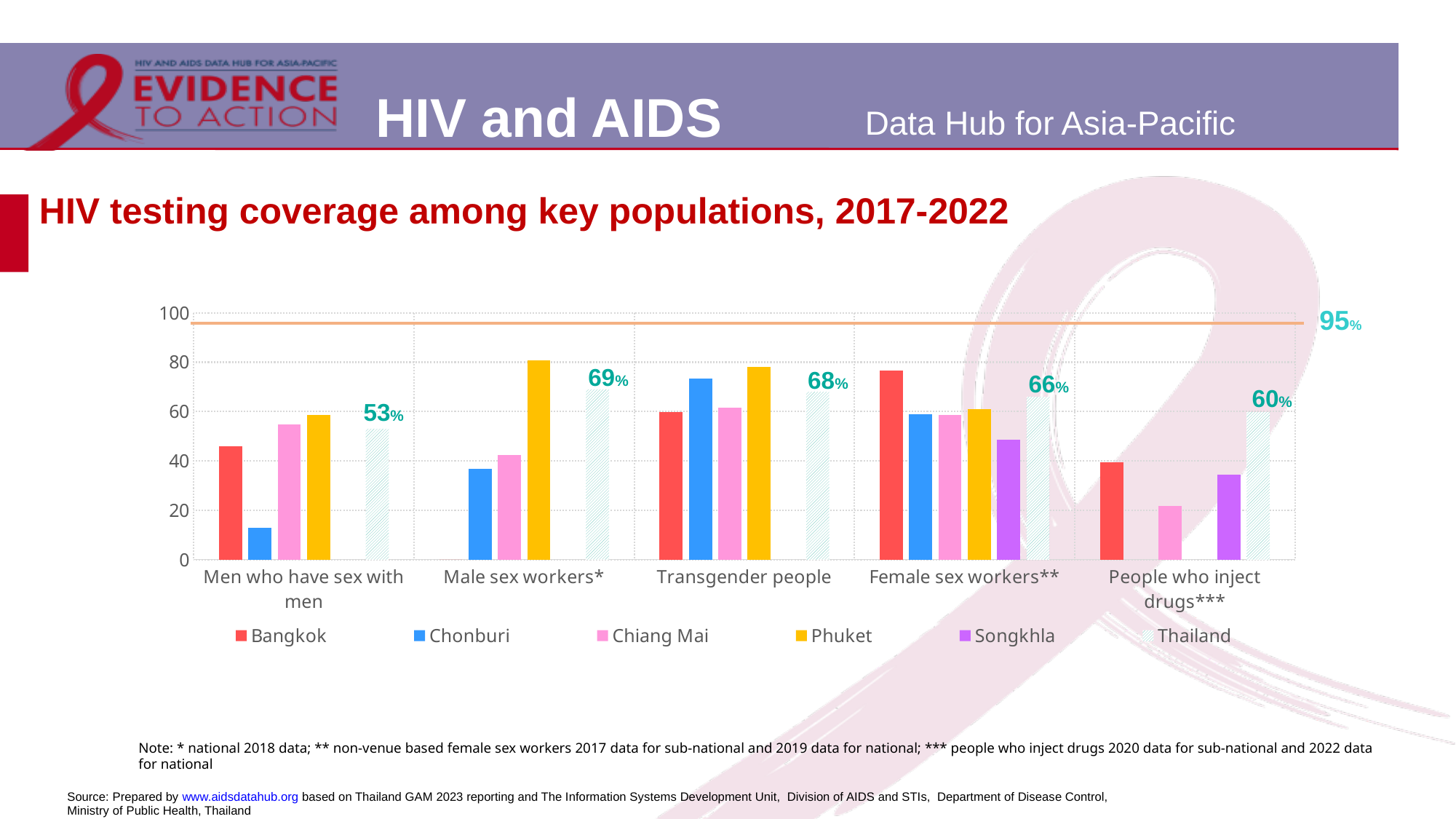
What is the difference between the Thailand values for Male sex workers and Men who have sex with men? 16 percentage points What value does the horizontal reference line across the chart mark? 95% For Men who have sex with men, which is larger: the Bangkok bar or the Chonburi bar? Bangkok Is the Bangkok value for Female sex workers greater or less than 60? greater What is the Thailand value for People who inject drugs? 60% What is the Thailand value for Male sex workers? 69% What is the Thailand value for Men who have sex with men? 53% How many series does the legend list? 6 Among the Thailand values, which key population has the lowest HIV testing coverage? Men who have sex with men Among the Thailand values, which key population has the highest HIV testing coverage? Male sex workers Is the Chonburi value for Men who have sex with men greater or less than 20? less How many key population categories are shown on the x axis? 5